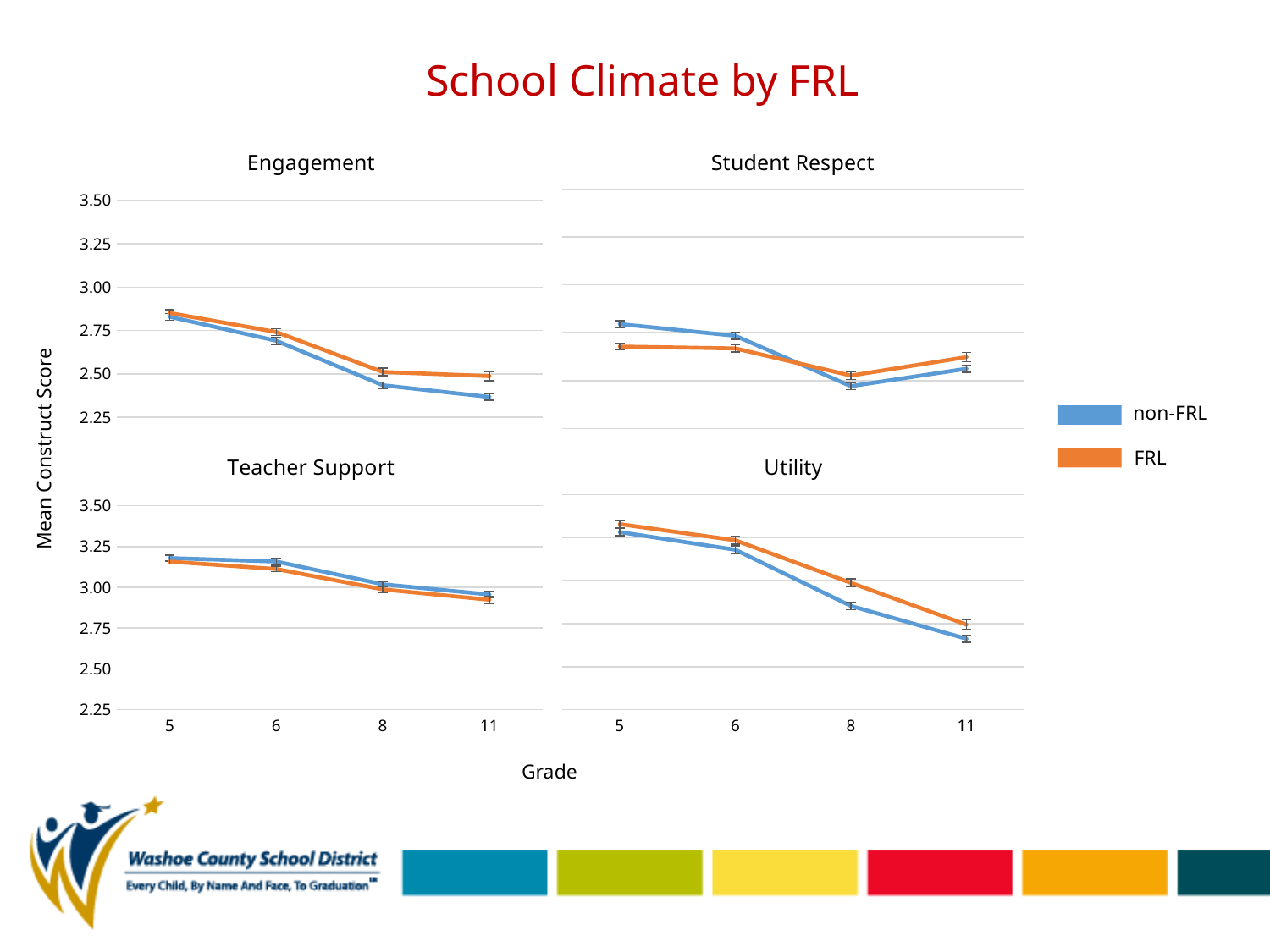
In the Utility chart, is the FRL value at grade 5 greater or less than 3.25? greater How many grade levels are plotted on the x axis of the Utility chart? 4 In the Utility chart, at which grade is the non-FRL value highest? 5 In the Student Respect chart, do the values rise or fall between grade 8 and grade 11? rise What kind of chart is the Engagement chart? line chart In the Utility chart, which series has the higher value at grade 8, non-FRL or FRL? FRL In the Student Respect chart, which series has the higher value at grade 5, non-FRL or FRL? non-FRL In the Engagement chart, do the non-FRL values rise or fall from grade 5 to grade 11? fall What colour represents the FRL series in the legend? orange In the Engagement chart, is the non-FRL value at grade 11 greater or less than 2.50? less How many series does the legend list? 2 In the Teacher Support chart, is the non-FRL value at grade 5 greater or less than 3.00? greater